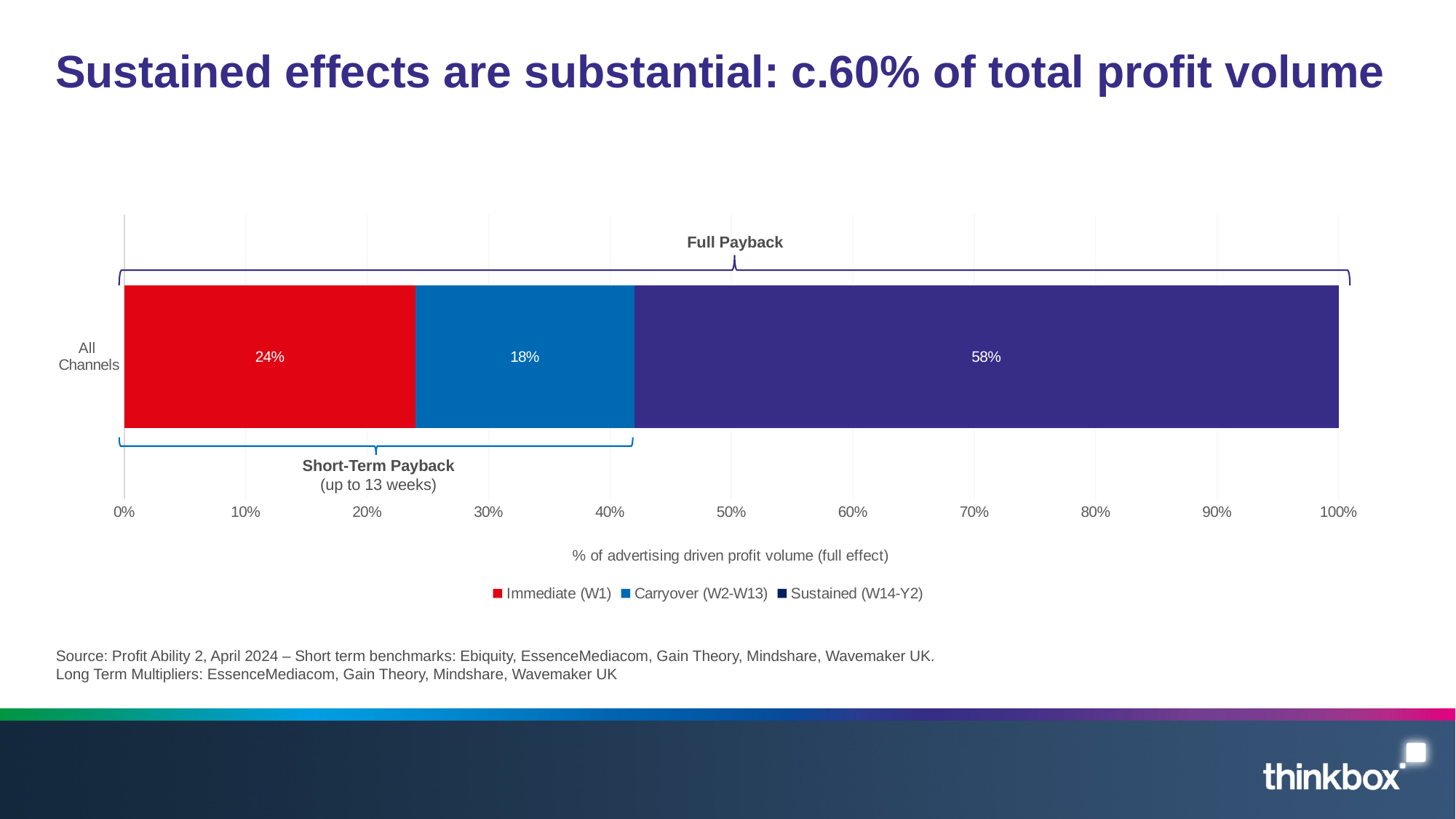
What is the difference between the Sustained (W14-Y2) value and the Immediate (W1) value? 34% What is the value for Carryover (W2-W13) for All Channels? 18% What is the total of the Immediate (W1) and Carryover (W2-W13) segments (Short-Term Payback)? 42% What kind of chart is shown on the slide? Stacked bar chart What is the value for Immediate (W1) for All Channels? 24% What is the x-axis label of the chart? % of advertising driven profit volume (full effect) Which is larger for All Channels, Immediate (W1) or Carryover (W2-W13)? Immediate (W1) What label is shown on the bracket below the Immediate and Carryover segments? Short-Term Payback (up to 13 weeks) How many series does the legend list? 3 Which series has the smallest share of the All Channels bar? Carryover (W2-W13) Which series has the largest share of the All Channels bar? Sustained (W14-Y2) What is the value for Sustained (W14-Y2) for All Channels? 58%